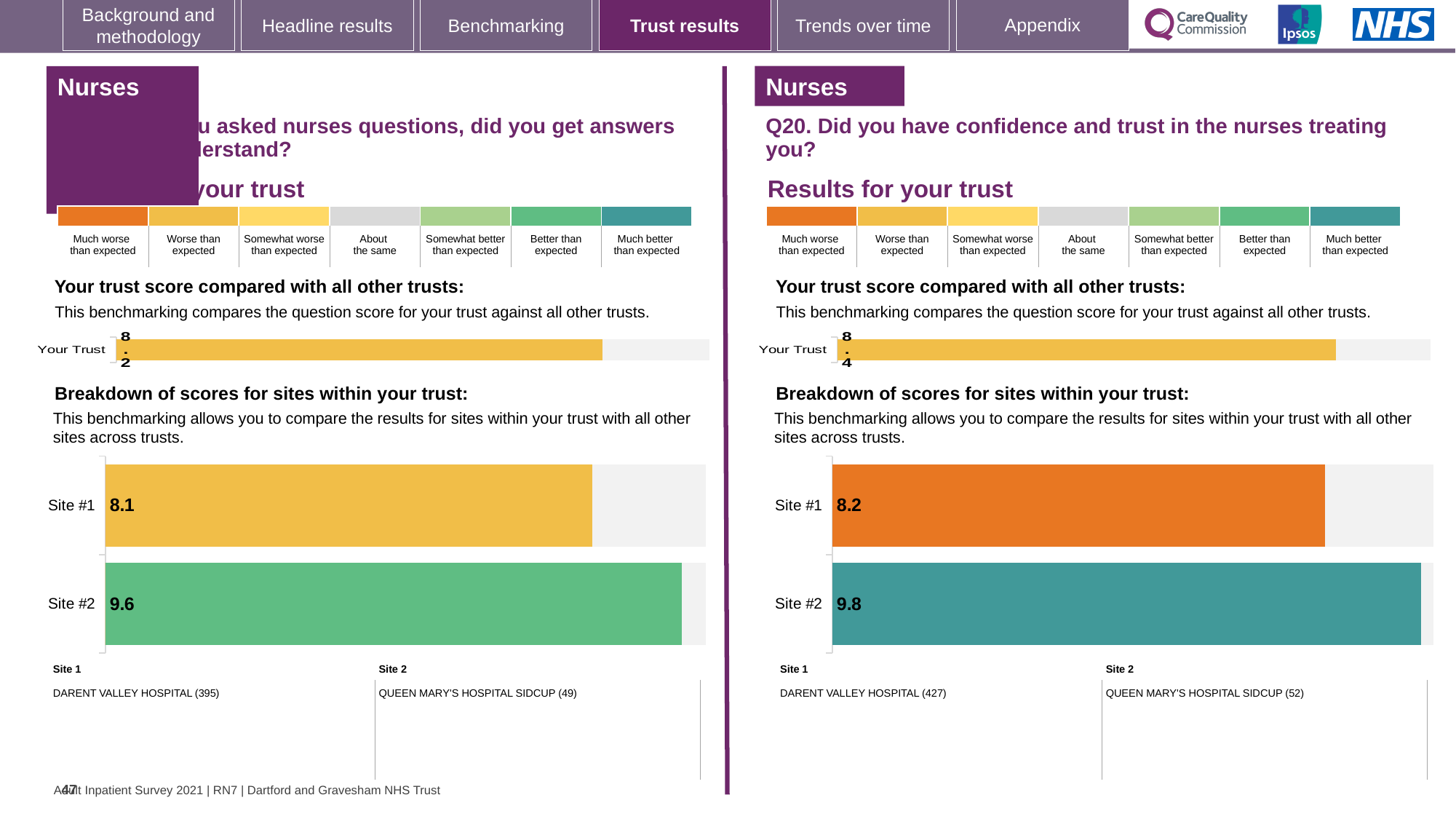
On the left-hand 'Your Trust' bar chart, what is the trust score shown? 8.2 On the Q20 (right-hand) 'Your Trust' bar chart, what is the trust score shown? 8.4 What type of chart is used for the site breakdown on the left-hand side of the slide? Bar chart On the left-hand site breakdown chart, what is the score for Site #1? 8.1 How many sites are shown on the Q20 (right-hand) site breakdown chart? 2 On the Q20 (right-hand) site breakdown chart, what is the score for Site #2? 9.8 On the left-hand site breakdown chart, which site has the higher score? Site #2 On the Q20 (right-hand) site breakdown chart, what is the difference between the Site #2 and Site #1 scores? 1.6 On the left-hand site breakdown chart, what is the score for Site #2? 9.6 On the Q20 (right-hand) site breakdown chart, what is the score for Site #1? 8.2 On the left-hand site breakdown chart, what is the difference between the Site #2 and Site #1 scores? 1.5 On the Q20 (right-hand) site breakdown chart, which site has the lower score? Site #1